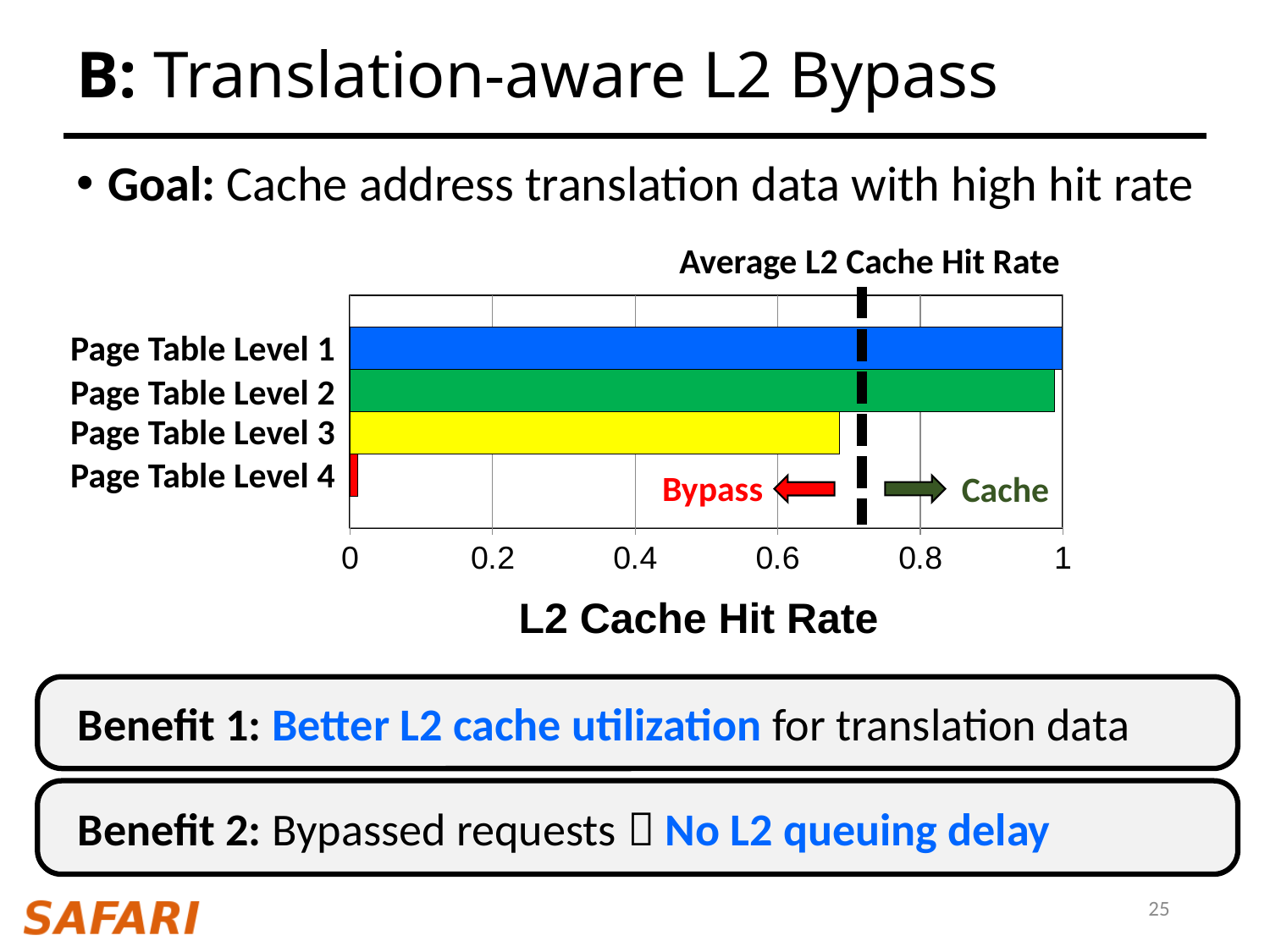
Which has a higher L2 cache hit rate, Page Table Level 1 or Page Table Level 3? Page Table Level 1 Is the L2 cache hit rate for Page Table Level 4 greater or less than 0.2? less Which page table level has the lowest L2 cache hit rate? Page Table Level 4 What kind of chart is shown on the slide? bar chart How many page table levels are plotted in the chart? 4 What does the dashed vertical line in the chart represent? Average L2 Cache Hit Rate What is the title of the horizontal axis of the chart? L2 Cache Hit Rate Is the L2 cache hit rate for Page Table Level 3 greater or less than 0.6? greater Is the L2 cache hit rate for Page Table Level 2 greater or less than 0.8? greater Which has a higher L2 cache hit rate, Page Table Level 3 or Page Table Level 4? Page Table Level 3 Do the L2 cache hit rates rise or fall going from Page Table Level 1 to Page Table Level 4? fall